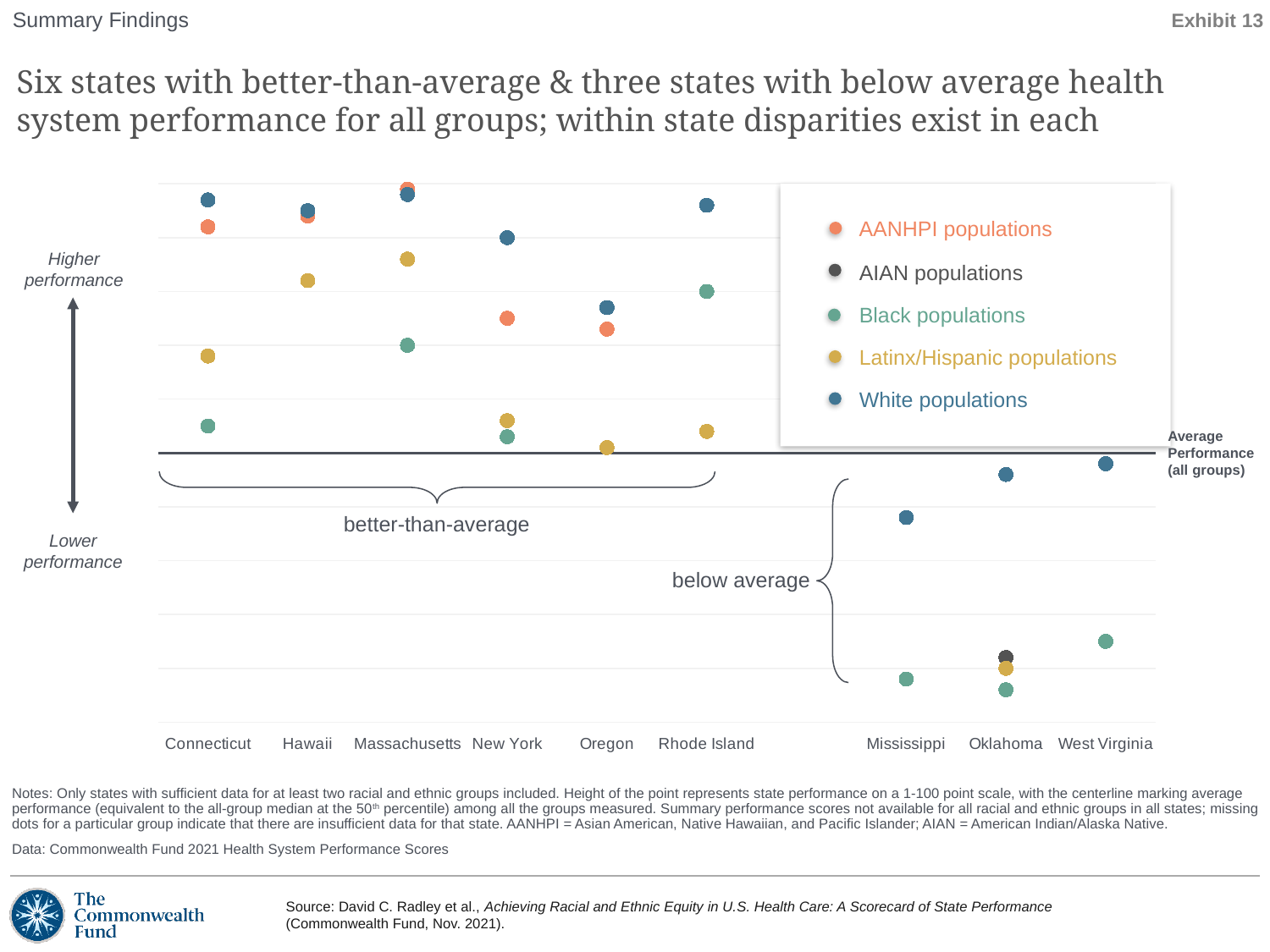
What kind of chart is shown on the slide? Scatter (dot) plot In Hawaii, which population group has the lowest point? Latinx/Hispanic populations How many states are shown along the x axis of the chart? 9 In Mississippi, which is higher: the point for White populations or the point for Black populations? White populations In Rhode Island, which is higher: the point for White populations or the point for Latinx/Hispanic populations? White populations How many states are grouped under the 'better-than-average' bracket? 6 In Massachusetts, which population group has the lowest point? Black populations In New York, which population group has the highest point? White populations How many population groups does the legend list? 5 In Connecticut, which population group has the lowest point? Black populations In Connecticut, which population group has the highest point? White populations Which states are grouped under the 'below average' bracket? Mississippi, Oklahoma, West Virginia